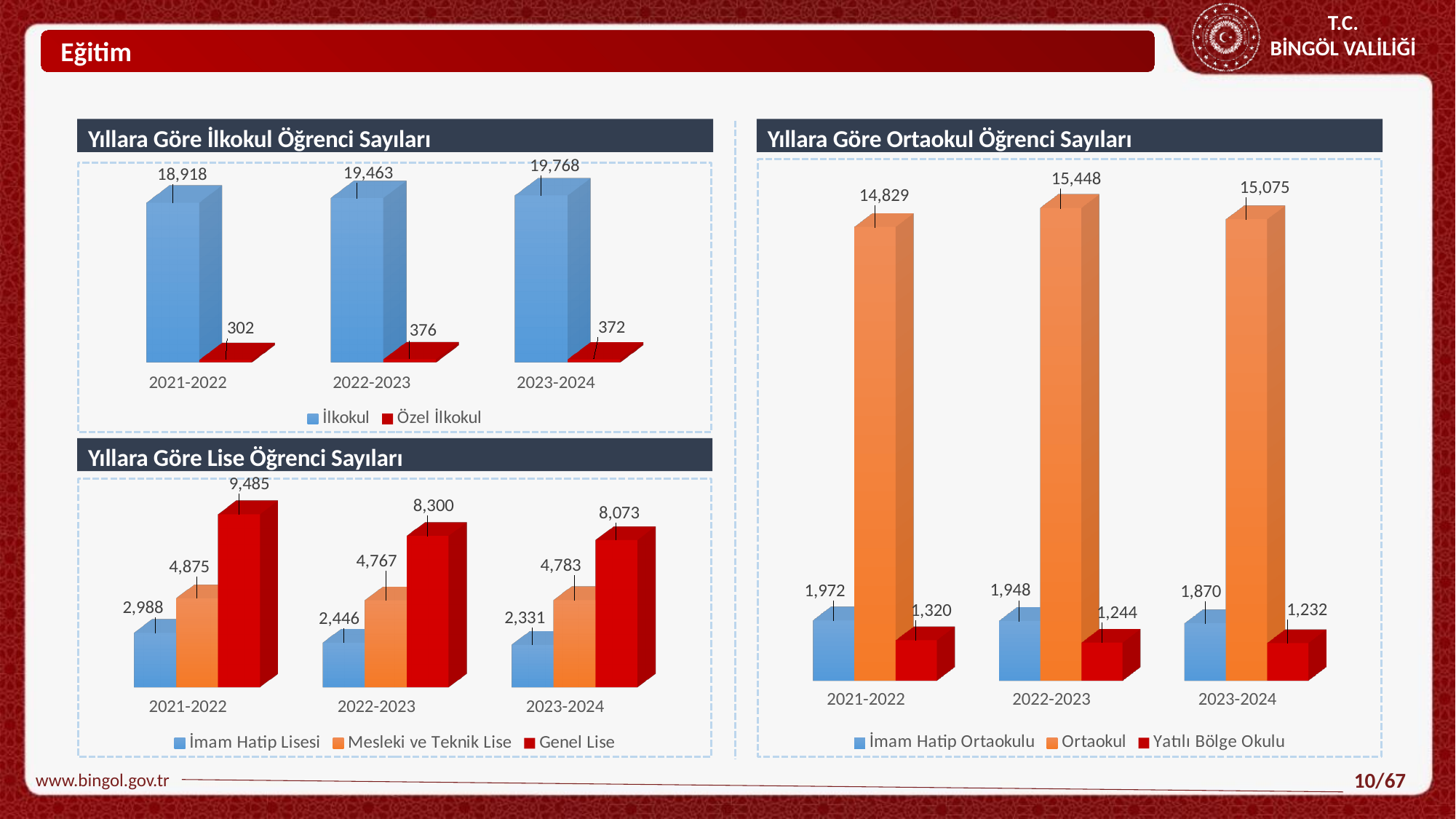
In the 'Yıllara Göre Lise Öğrenci Sayıları' chart, what is the Genel Lise value for 2021-2022? 9,485 In the 'Yıllara Göre İlkokul Öğrenci Sayıları' chart, does the İlkokul series rise or fall from 2021-2022 to 2023-2024? rise In the 'Yıllara Göre Ortaokul Öğrenci Sayıları' chart, what is the difference between the Yatılı Bölge Okulu values for 2021-2022 and 2023-2024? 88 In the 'Yıllara Göre Ortaokul Öğrenci Sayıları' chart, which year has the highest Ortaokul value? 2022-2023 In the 'Yıllara Göre Lise Öğrenci Sayıları' chart, how many series does the legend list? 3 In the 'Yıllara Göre Lise Öğrenci Sayıları' chart, which is larger: Mesleki ve Teknik Lise in 2022-2023 or in 2023-2024? 2023-2024 In the 'Yıllara Göre Lise Öğrenci Sayıları' chart, which year has the lowest İmam Hatip Lisesi value? 2023-2024 In the 'Yıllara Göre Ortaokul Öğrenci Sayıları' chart, what is the Ortaokul value for 2022-2023? 15,448 In the 'Yıllara Göre İlkokul Öğrenci Sayıları' chart, what is the difference between the İlkokul values for 2022-2023 and 2021-2022? 545 What kind of chart is 'Yıllara Göre Ortaokul Öğrenci Sayıları'? bar chart In the 'Yıllara Göre İlkokul Öğrenci Sayıları' chart, what is the İlkokul value for 2023-2024? 19,768 In the 'Yıllara Göre İlkokul Öğrenci Sayıları' chart, what is the Özel İlkokul value for 2021-2022? 302